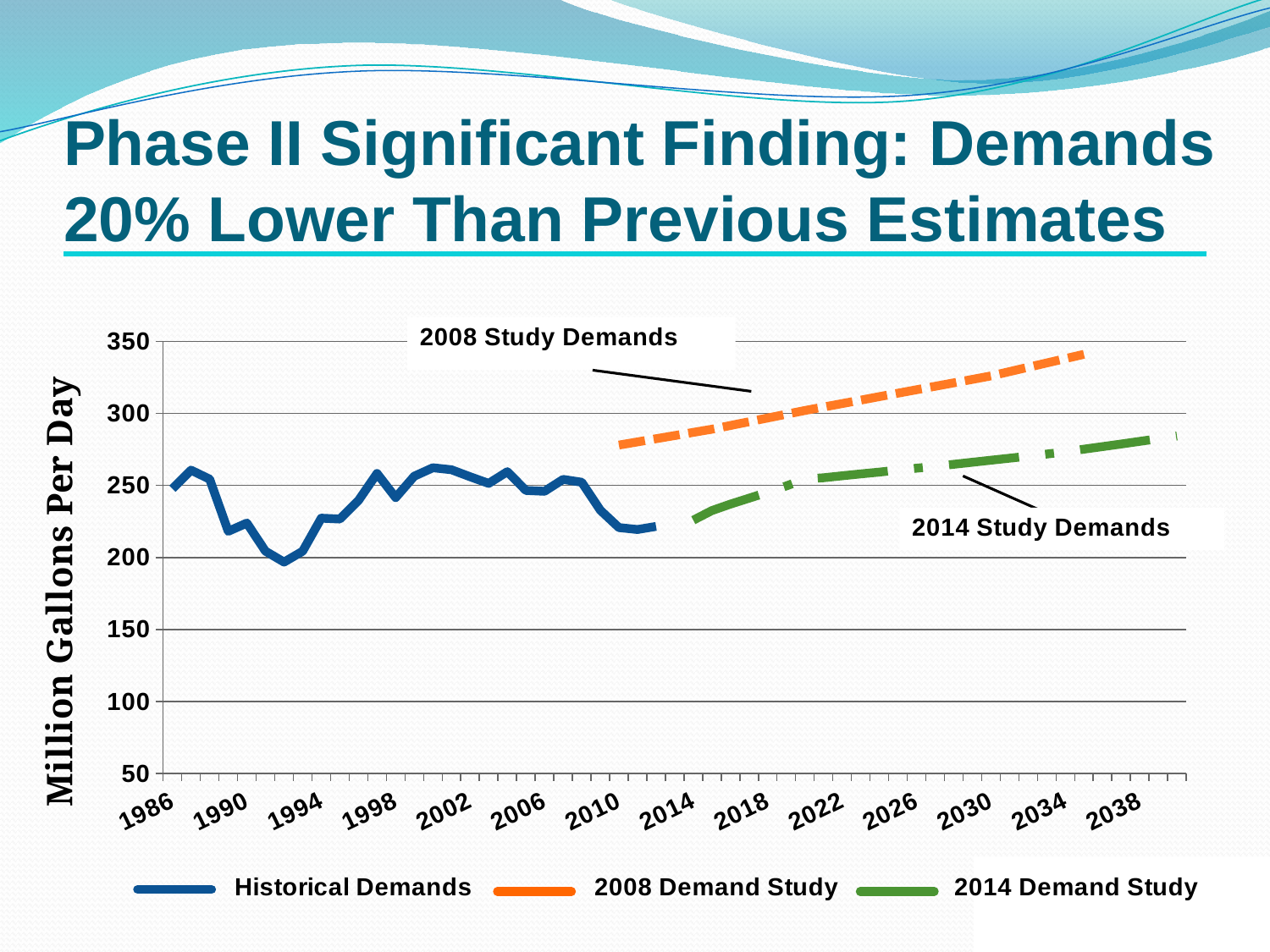
What kind of chart is shown on the slide? line chart Which series reaches the highest value on the chart? 2008 Demand Study At 2030, which series has the higher value: 2008 Demand Study or 2014 Demand Study? 2008 Demand Study What is the label on the vertical axis of the chart? Million Gallons Per Day Is the value of the Historical Demands series at 1994 greater or less than 250? less Is the value of the 2008 Demand Study series at 2034 greater or less than 300? greater Is the value of the 2014 Demand Study series at 2034 greater or less than 300? less What are the three series named in the chart legend? Historical Demands, 2008 Demand Study, 2014 Demand Study Do the values of the 2008 Demand Study series rise or fall from 2014 to 2034? rise How many series does the chart legend list? 3